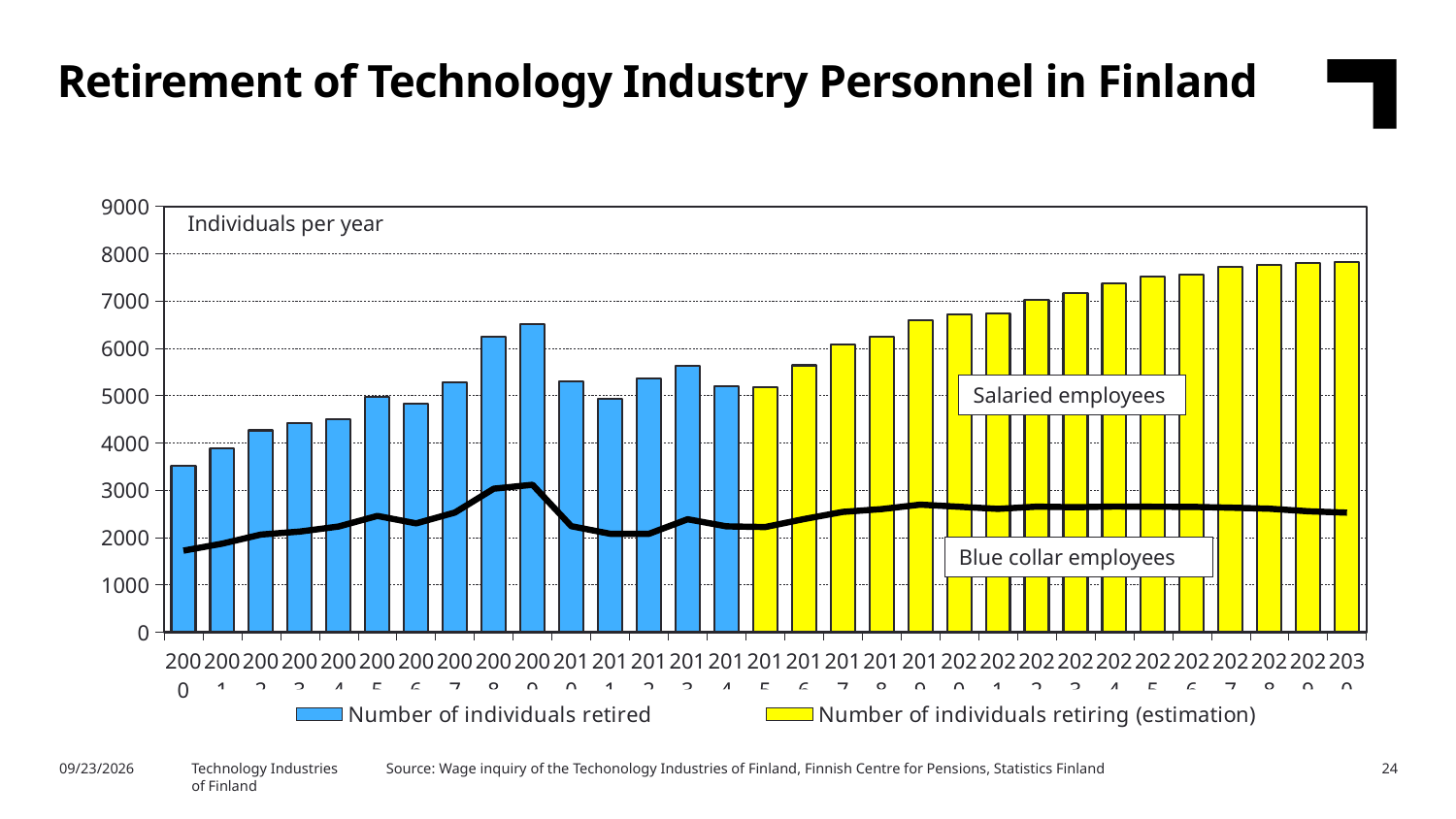
What is the title of the slide? Retirement of Technology Industry Personnel in Finland What kind of chart is shown on the slide? combination bar and line chart Is the value for 2000 greater or less than 3000? greater Which is larger, the value for 2009 or the value for 2010? 2009 How many years (bars) are plotted along the x axis? 31 Do the estimated values (yellow bars) rise or fall from 2015 to 2030? rise Which legend entry is shown in yellow? Number of individuals retiring (estimation) Which year has the lowest bar? 2000 Is the value for 2030 greater or less than 8000? less How many entries does the legend list? 2 Is the value for 2009 greater or less than 6000? greater